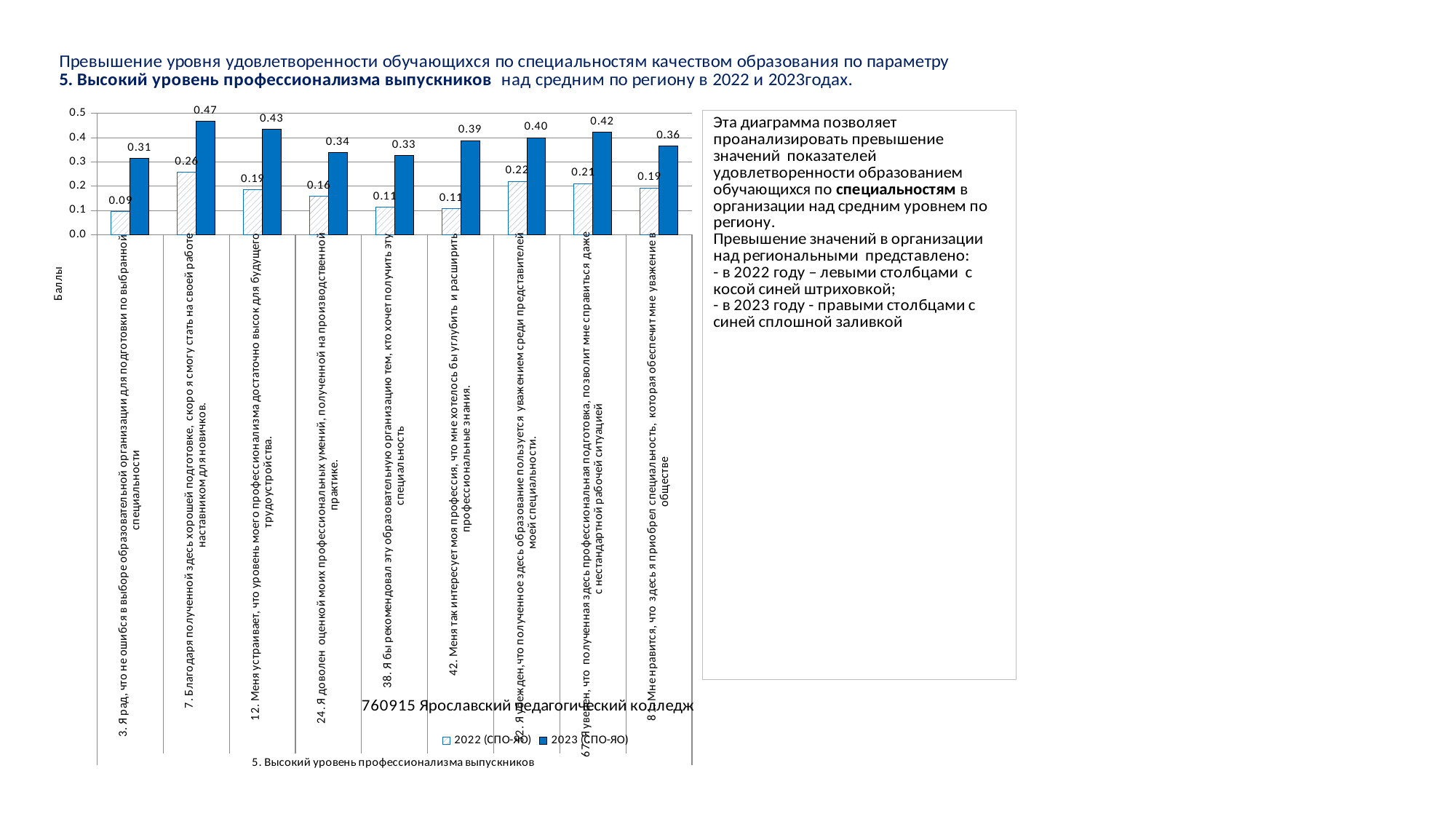
What kind of chart is shown on the slide? bar chart What is the 2023 (СПО-ЯО) value for statement 7 ("Благодаря полученной здесь хорошей подготовке, скоро я смогу стать на своей работе наставником для новичков")? 0.47 What is the difference between the 2023 and 2022 values for statement 12 ("Меня устраивает, что уровень моего профессионализма достаточно высок...")? 0.24 Which is larger for statement 24 ("Я доволен оценкой моих профессиональных умений..."): the 2022 value or the 2023 value? 2023 (СПО-ЯО) What is the 2023 (СПО-ЯО) value for statement 42 ("Меня так интересует моя профессия...")? 0.39 Is the 2023 (СПО-ЯО) value for statement 38 ("Я бы рекомендовал эту образовательную организацию...") greater or less than 0.3? greater What is the label of the chart's vertical axis? Баллы How many series does the chart legend list? 2 How many categories (statements) are plotted on the x axis of the chart? 9 Which statement has the lowest 2022 (СПО-ЯО) value? 3. Я рад, что не ошибся в выборе образовательной организации для подготовки по выбранной специальности What is the 2022 (СПО-ЯО) value for statement 3 ("Я рад, что не ошибся в выборе образовательной организации...")? 0.09 Which statement has the highest 2023 (СПО-ЯО) value? 7. Благодаря полученной здесь хорошей подготовке, скоро я смогу стать на своей работе наставником для новичков